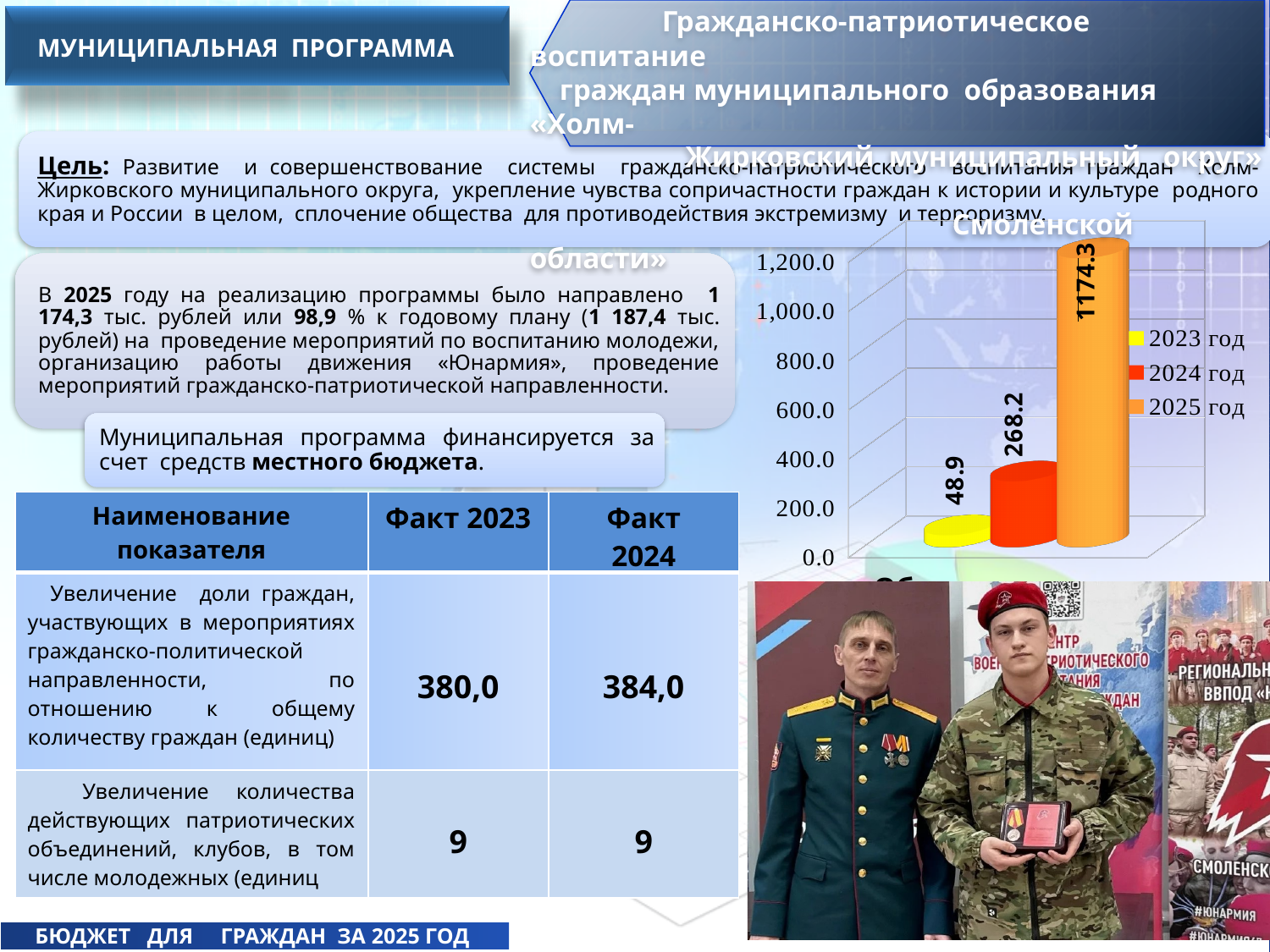
What is the value for 2023 год in the chart? 48.9 What is the value for 2024 год in the chart? 268.2 Is the value for 2024 год greater or less than 400.0? less What is the value for 2025 год in the chart? 1174.3 How many series does the chart legend list? 3 What kind of chart is shown on the slide? bar chart What is the difference between the values for 2025 год and 2024 год? 906.1 Which is larger, the value for 2024 год or the value for 2023 год? 2024 год Which year has the highest value in the chart? 2025 год Which year has the lowest value in the chart? 2023 год What colour is the bar for 2023 год in the chart? yellow What is the difference between the values for 2024 год and 2023 год? 219.3